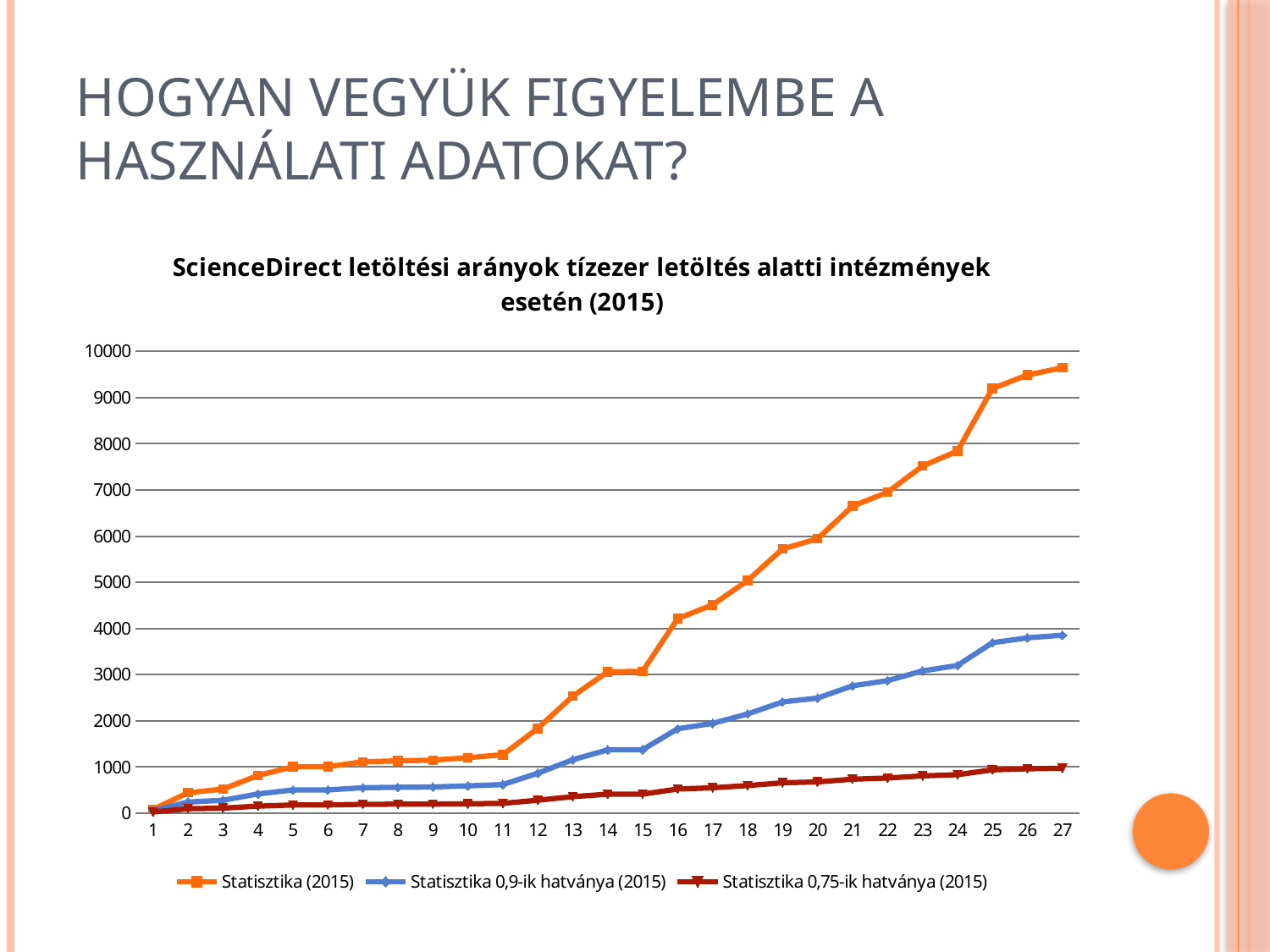
What is the title of the chart? ScienceDirect letöltési arányok tízezer letöltés alatti intézmények esetén (2015) Do the values of the Statisztika (2015) series rise or fall from point 1 to point 27? rise How many points are plotted along the x axis for each series? 27 At which point does the Statisztika (2015) series reach its highest value? 27 Is the value of Statisztika (2015) at point 27 greater or less than 9000? greater What kind of chart is shown on the slide? line chart Is the value of Statisztika 0,9-ik hatványa (2015) at point 27 greater or less than 4000? less Is the value of Statisztika (2015) at point 16 greater or less than 4000? greater How many series does the legend list? 3 Which series has the lowest values across the chart? Statisztika 0,75-ik hatványa (2015) At point 20, which series has the larger value: Statisztika (2015) or Statisztika 0,9-ik hatványa (2015)? Statisztika (2015)